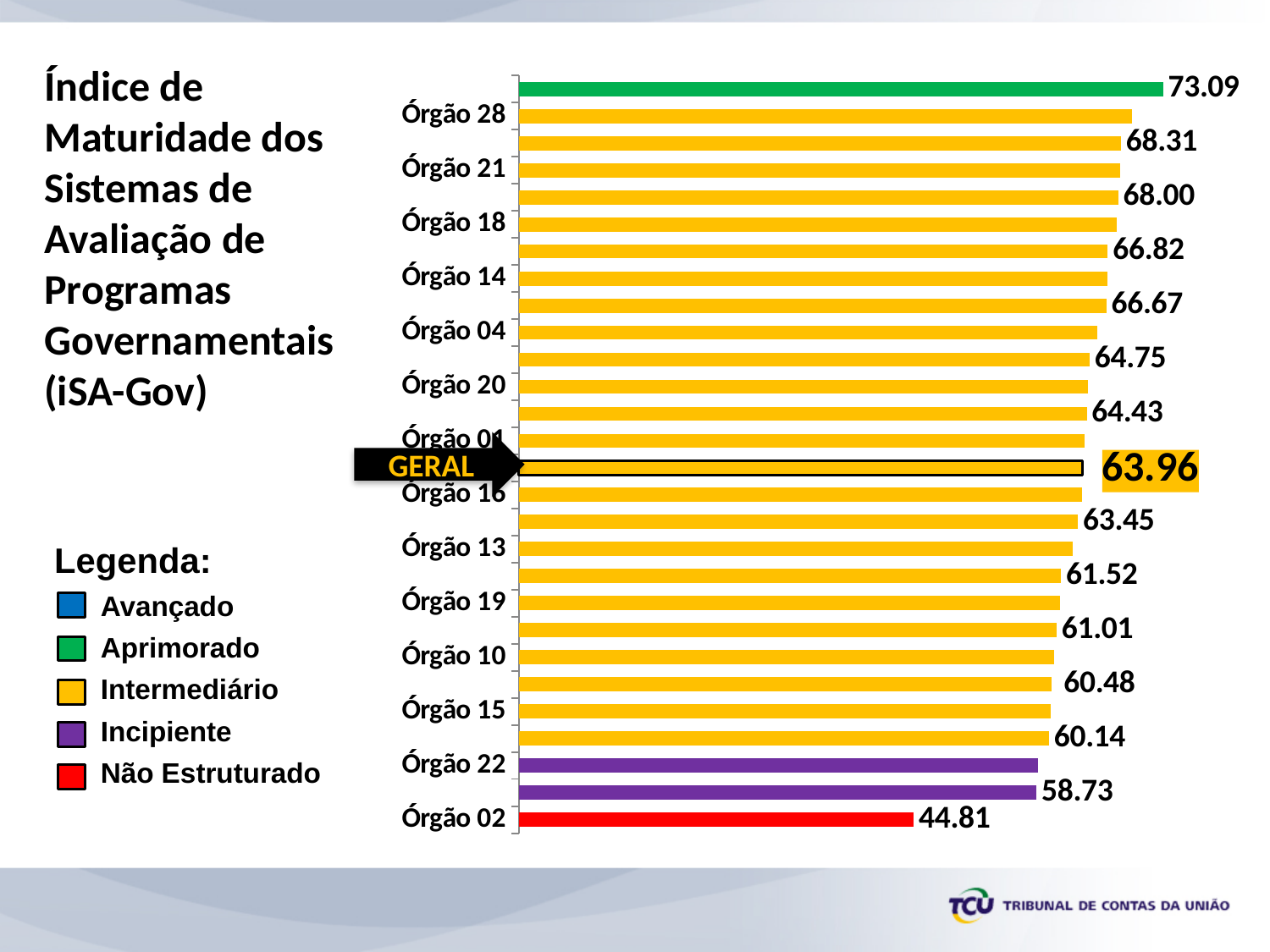
How many categories does the legend (Legenda) list? 5 Which category has the lowest value? Órgão 02 Which is larger, the value for Órgão 22 or the value for Órgão 02? Órgão 22 Do the bar values increase or decrease going from the top of the chart to the bottom? decrease What type of chart is shown on the slide? bar chart What is the difference between the highest value (73.09) and the value for Órgão 02? 28.28 Which is larger, the value for Órgão 28 or the value for Órgão 02? Órgão 28 What is the value of the GERAL bar? 63.96 What is the highest value shown on the chart? 73.09 What is the value for Órgão 02? 44.81 What is the difference between the GERAL value and the value for Órgão 02? 19.15 According to the legend, which maturity level does the red bar for Órgão 02 represent? Não Estruturado